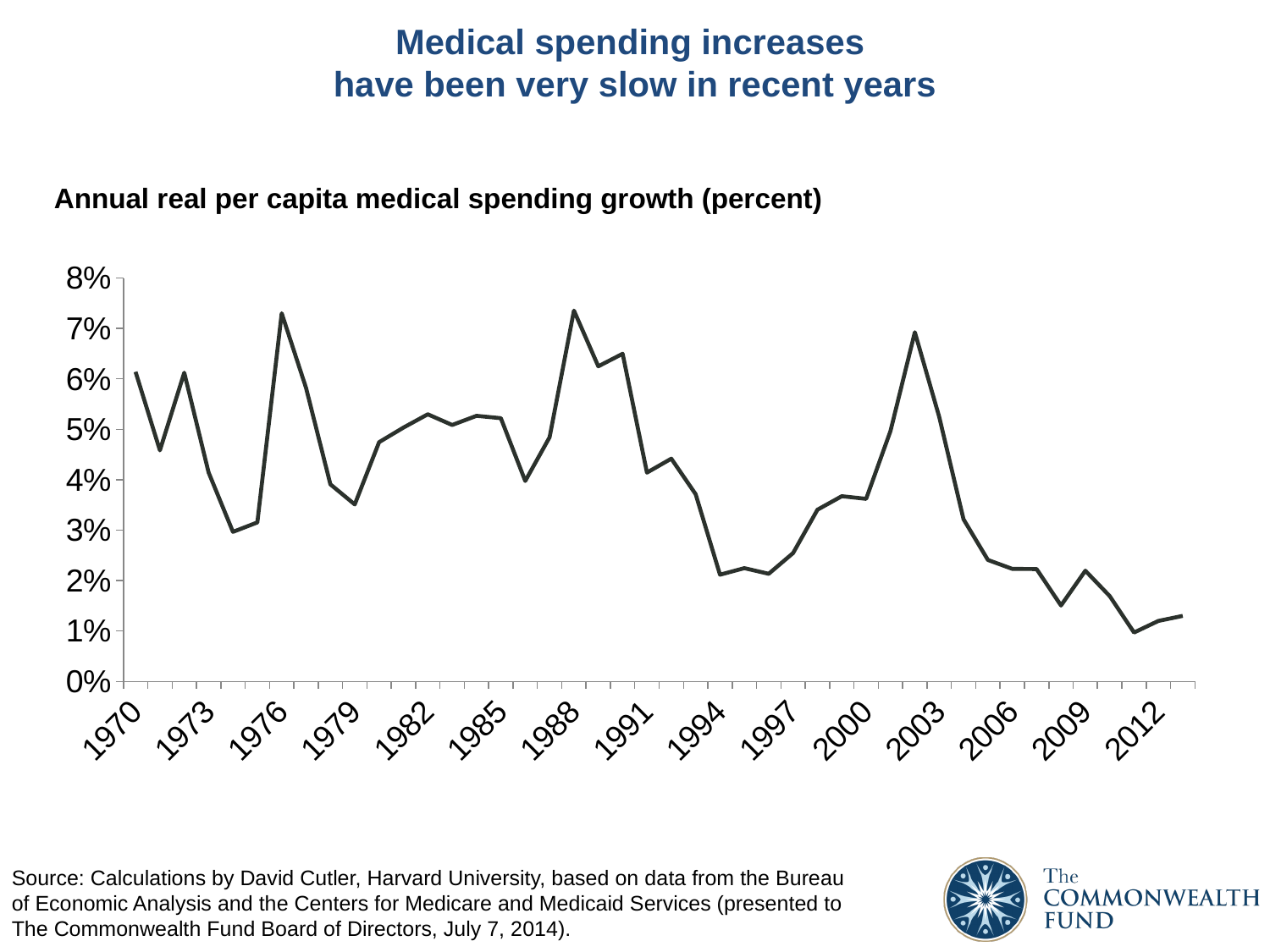
Is the value for 1994 greater or less than 3%? less Is the value for 1970 greater or less than 5%? greater Is the value for 2012 greater or less than 2%? less What kind of chart is shown on the slide? line chart What is the title of the slide? Medical spending increases have been very slow in recent years Which year has the larger value, 1976 or 1994? 1976 Do the values generally rise or fall from 2003 to 2012? fall Which year has the larger value, 2003 or 2012? 2003 What quantity does the chart plot, according to the label above it? Annual real per capita medical spending growth (percent)